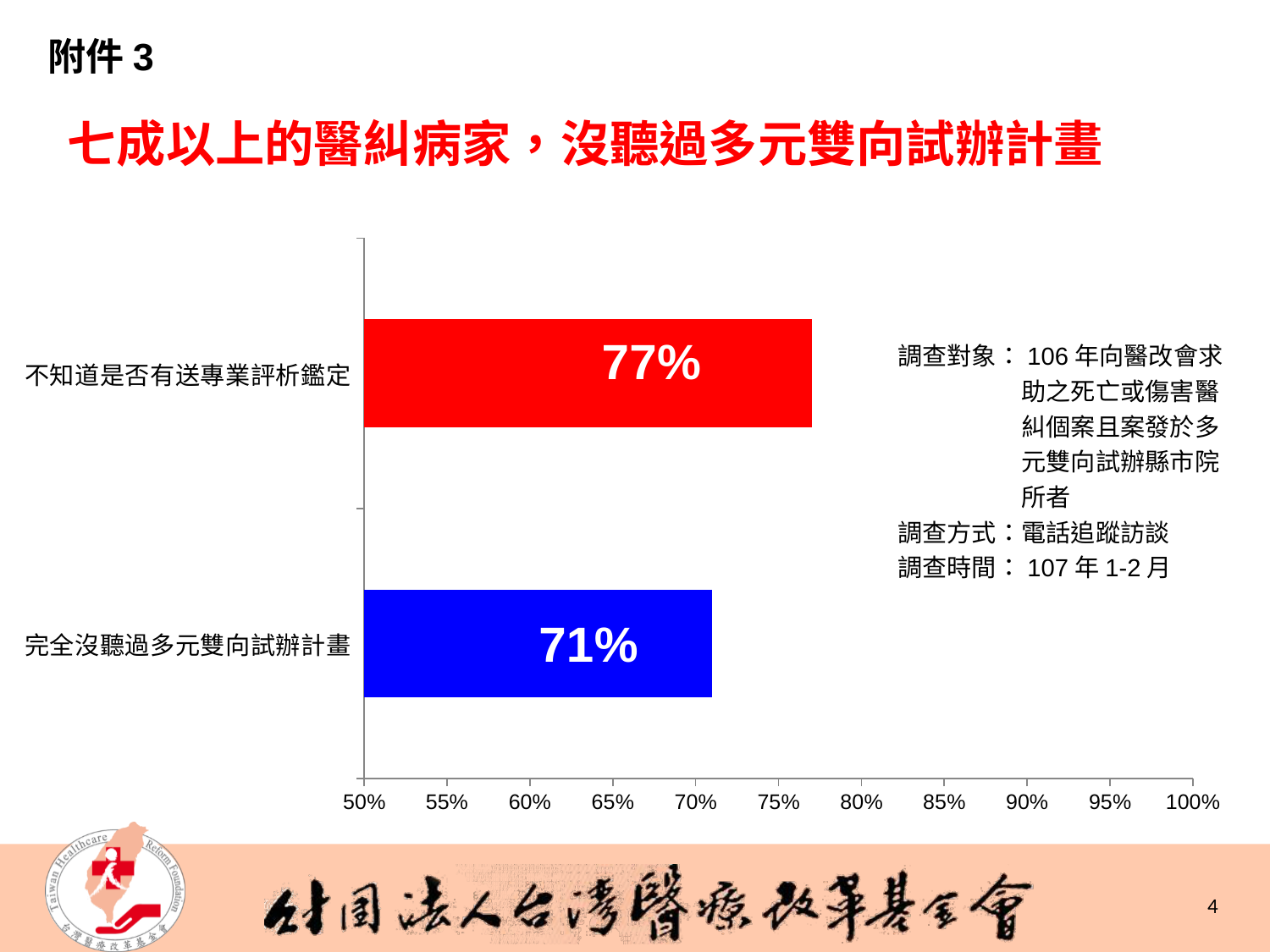
Is the value for 不知道是否有送專業評析鑑定 greater or less than 75%? greater How many categories are shown in the chart? 2 Which category has the lowest value? 完全沒聽過多元雙向試辦計畫 What is the value for 完全沒聽過多元雙向試辦計畫? 71% What is the value for 不知道是否有送專業評析鑑定? 77% What is the lowest value shown on the x axis of the chart? 50% What colour is the bar for 完全沒聽過多元雙向試辦計畫? blue Is the value for 完全沒聽過多元雙向試辦計畫 greater or less than 75%? less What is the difference between the values for 不知道是否有送專業評析鑑定 and 完全沒聽過多元雙向試辦計畫? 6% Which category has the highest value? 不知道是否有送專業評析鑑定 Which is larger: the value for 不知道是否有送專業評析鑑定 or the value for 完全沒聽過多元雙向試辦計畫? 不知道是否有送專業評析鑑定 What kind of chart is shown on the slide? bar chart